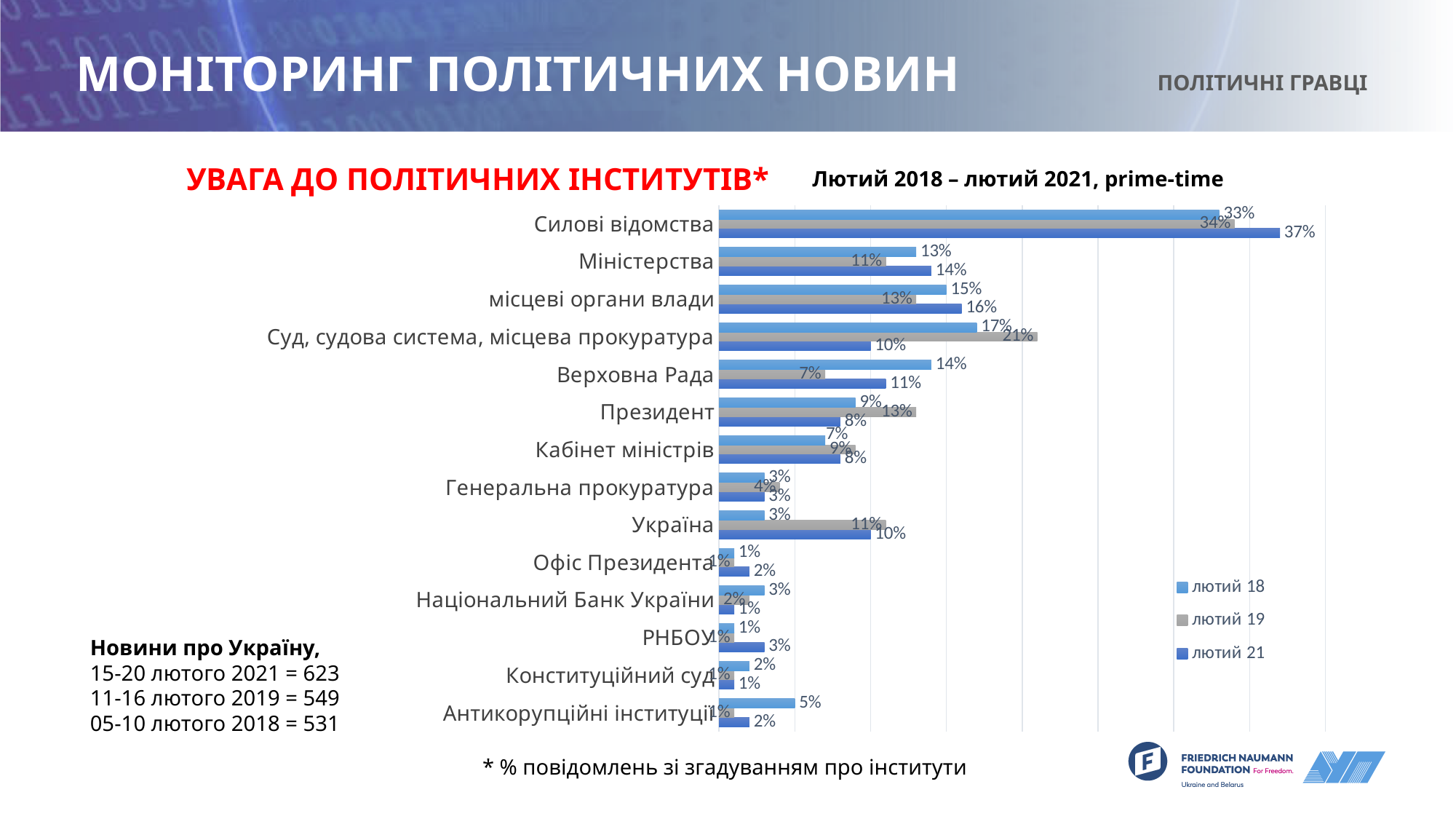
What is the value for Антикорупційні інституції in лютий 18? 5% How many categories are shown on the chart? 14 How many series does the legend list? 3 What type of chart is shown on the slide? bar chart Which category has the highest value in лютий 21? Силові відомства Which is larger for Україна: the лютий 19 value or the лютий 18 value? лютий 19 Which series is shown in grey in the legend? лютий 19 What is the difference between the лютий 18 and лютий 21 values for Суд, судова система, місцева прокуратура? 7% What is the value for Суд, судова система, місцева прокуратура in лютий 19? 21% What is the value for Силові відомства in лютий 21? 37% What is the difference between the лютий 19 and лютий 21 values for Силові відомства? 3% What is the value for Верховна Рада in лютий 18? 14%